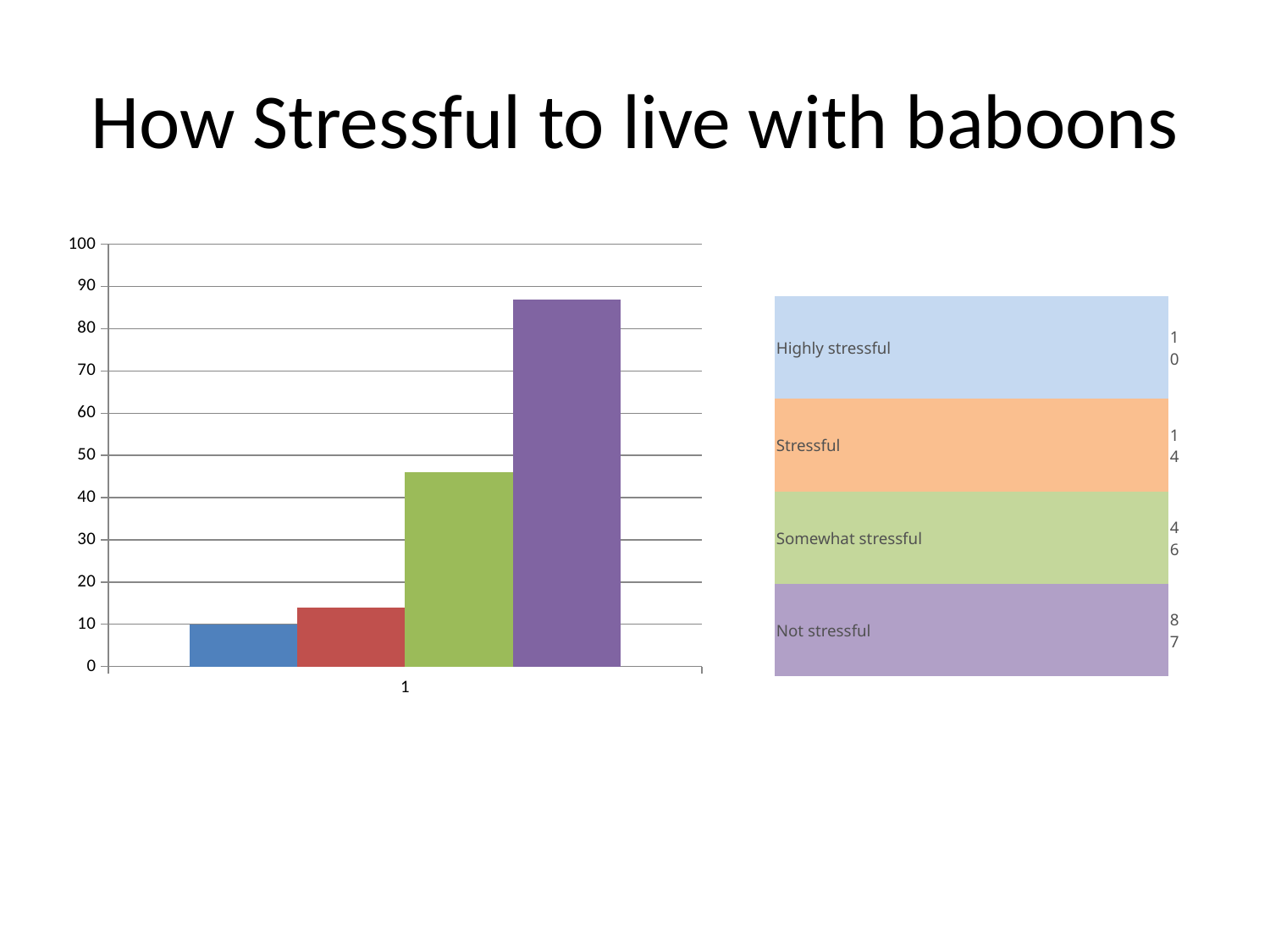
How many bars are plotted in the chart? 4 What kind of chart is shown on the slide? bar chart According to the table next to the chart, what is the value for Highly stressful? 10 According to the table next to the chart, what is the value for Somewhat stressful? 46 Is the value of the tallest (purple) bar greater or less than 80? greater Which category has the lowest value? Highly stressful According to the table next to the chart, what is the value for Stressful? 14 According to the table next to the chart, what is the value for Not stressful? 87 Which category has the highest value? Not stressful Which is larger, the value for Stressful or the value for Somewhat stressful? Somewhat stressful What is the title of the slide? How Stressful to live with baboons What is the difference between the values for Not stressful and Somewhat stressful? 41